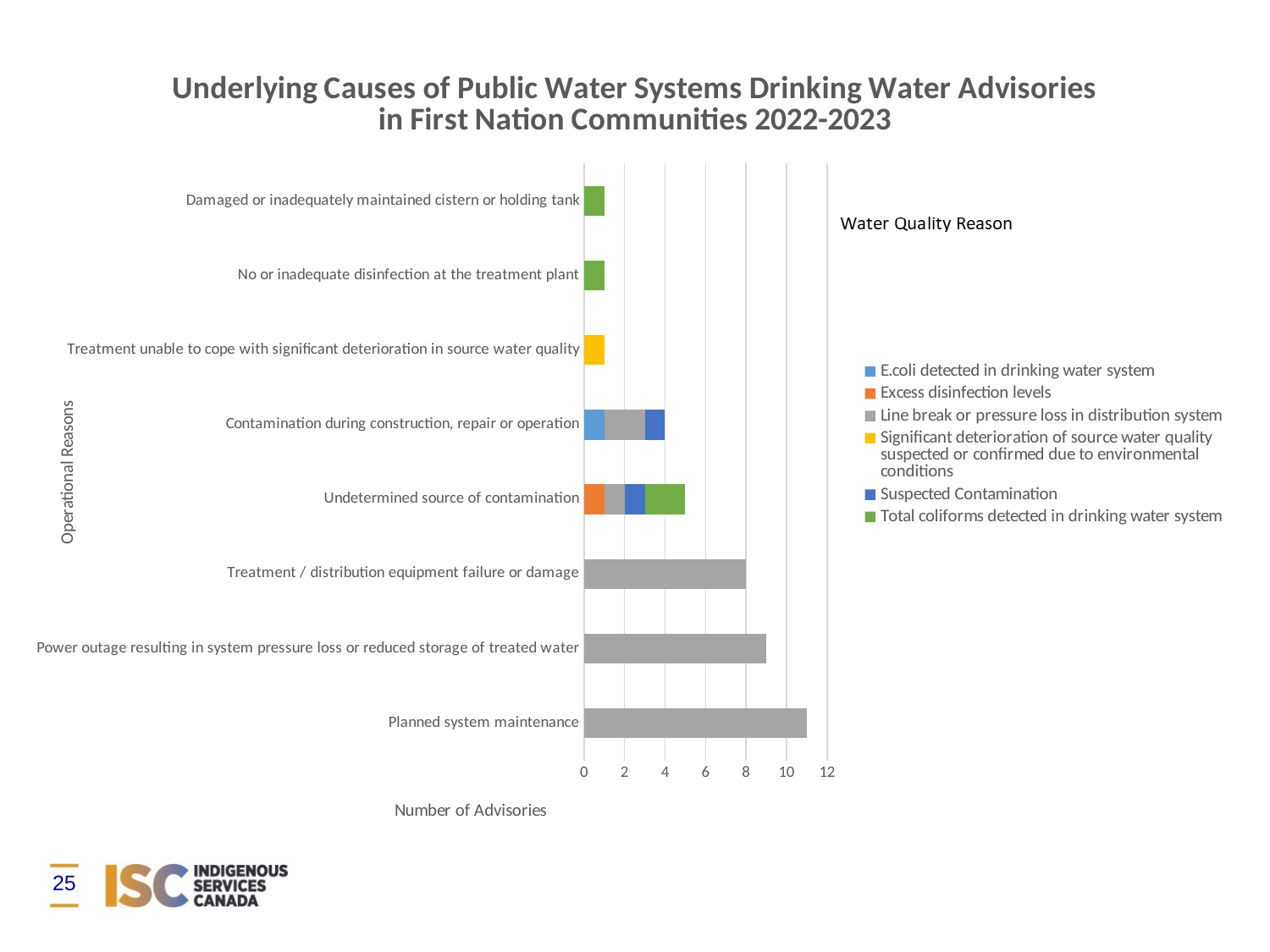
What kind of chart is shown on the slide? bar chart What is the title of the horizontal axis? Number of Advisories How many advisories are shown for Treatment / distribution equipment failure or damage? 8 What is the title shown above the legend? Water Quality Reason How many operational reason categories are plotted on the chart? 8 Is the value for Power outage resulting in system pressure loss or reduced storage of treated water greater or less than 8? greater Is the value for Planned system maintenance greater or less than 10? greater Which has more advisories: Planned system maintenance or Power outage resulting in system pressure loss or reduced storage of treated water? Planned system maintenance What is the total number of advisories for Contamination during construction, repair or operation? 4 Is the value for Undetermined source of contamination greater or less than 6? less Which operational reason has the highest number of advisories? Planned system maintenance How many water quality reasons does the legend list? 6